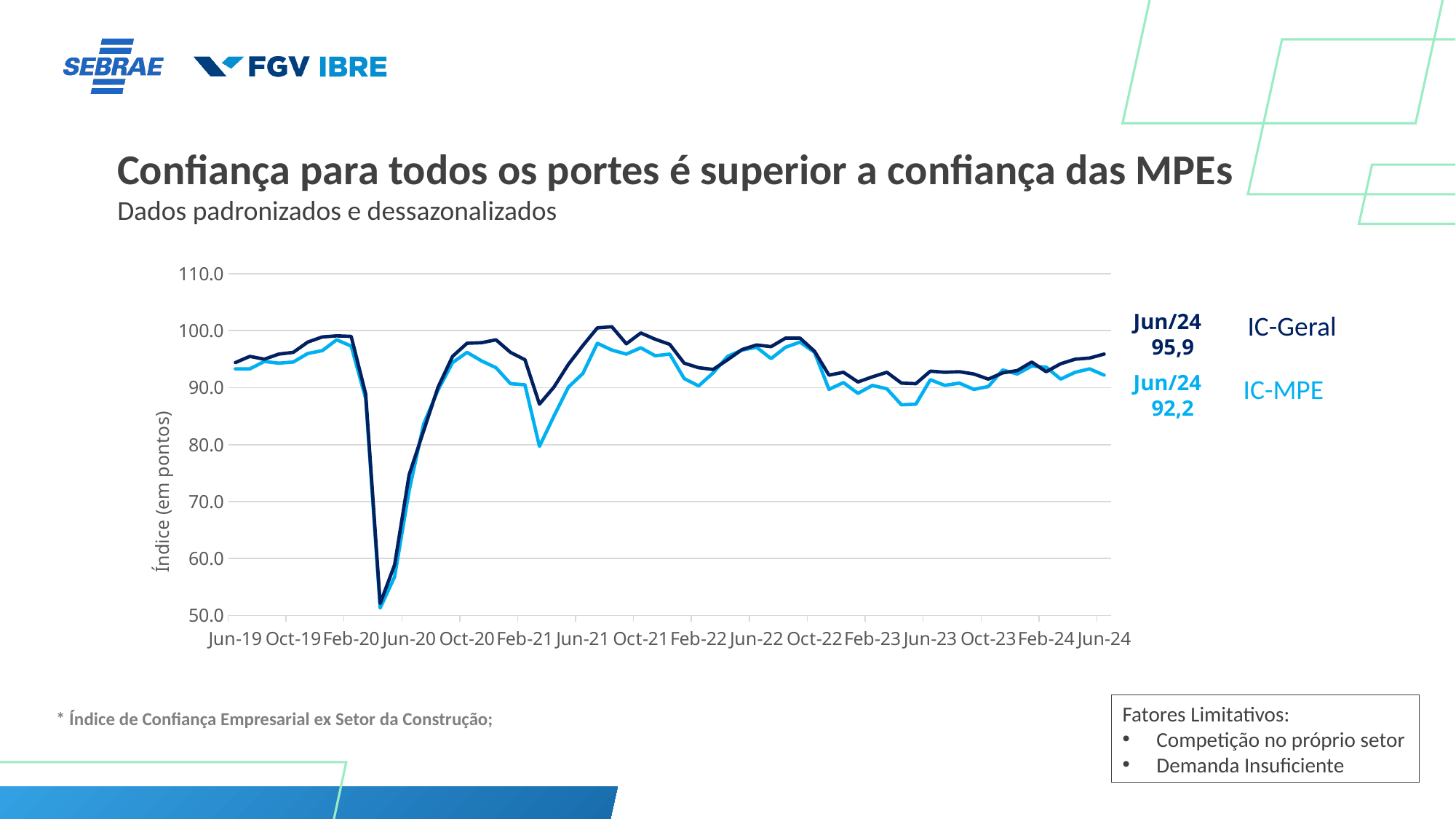
What is the title of the y axis? Índice (em pontos) How many date labels are shown on the x axis? 16 What is the value of IC-Geral in Jun/24? 95,9 What kind of chart is shown on the slide? line chart Is the value of IC-Geral at Jun-19 greater or less than 90.0? greater How many series are plotted on the chart? 2 Is the lowest point of the IC-MPE line greater or less than 60.0? less What is the value of IC-MPE in Jun/24? 92,2 What is the difference between the IC-Geral and IC-MPE values in Jun/24? 3,7 Between Jun-19 and Feb-20, does the IC-Geral line rise or fall? rise Which series has the higher value in Jun/24, IC-Geral or IC-MPE? IC-Geral Is the value of IC-MPE at Jun-20 greater or less than 90.0? less